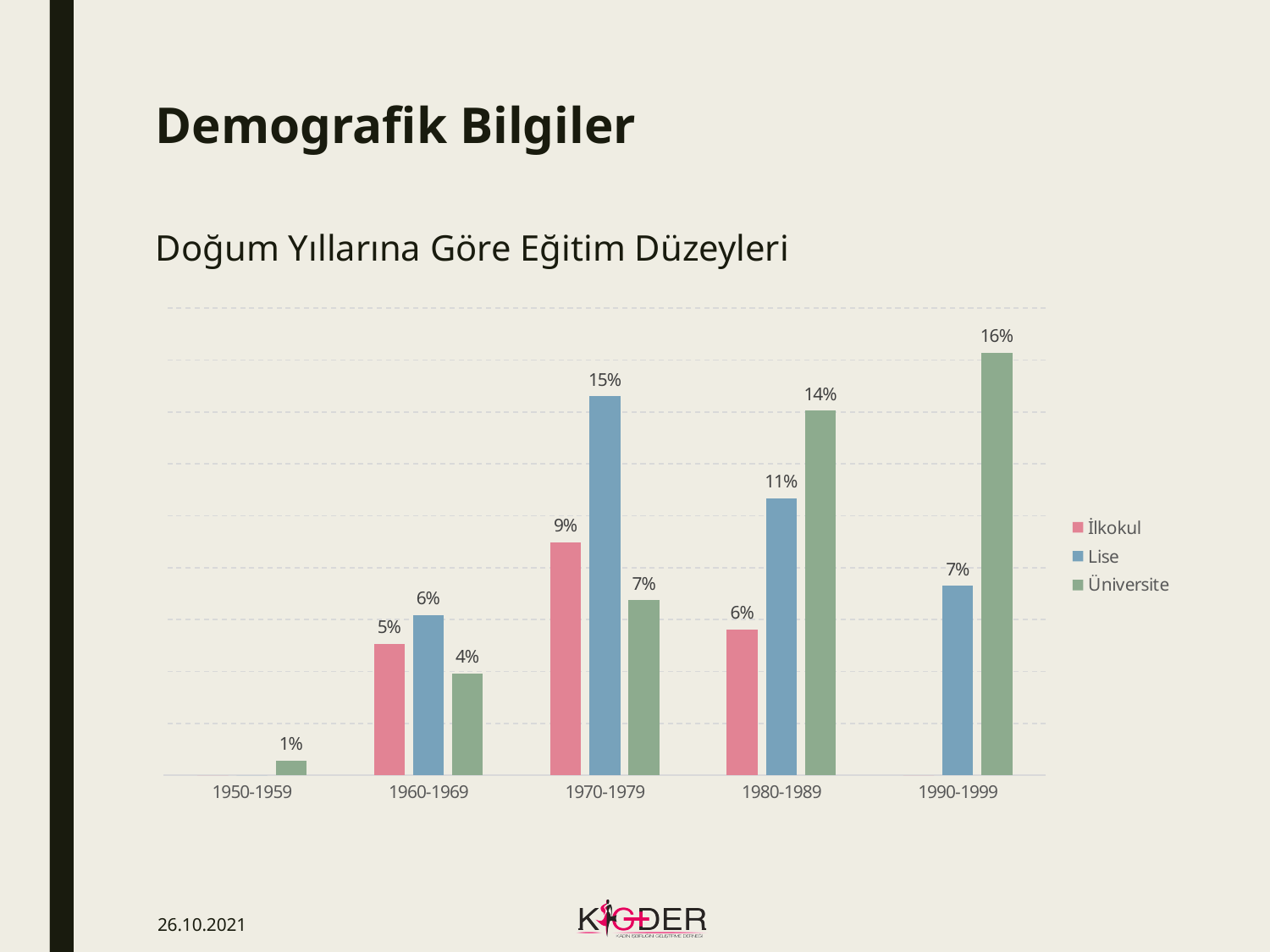
How many series does the legend list? 3 Which birth-year group has the lowest Üniversite value? 1950-1959 What is the difference between the Lise and Üniversite values for 1970-1979? 8% What is the Üniversite value for 1950-1959? 1% Which is larger for 1980-1989, Lise or Üniversite? Üniversite What is the İlkokul value for 1980-1989? 6% What is the title of the chart? Doğum Yıllarına Göre Eğitim Düzeyleri Which birth-year group has the highest Üniversite value? 1990-1999 What is the Lise value for 1970-1979? 15% What is the Üniversite value for 1990-1999? 16% How many birth-year groups are shown on the x axis? 5 What kind of chart is shown on the slide? Bar chart